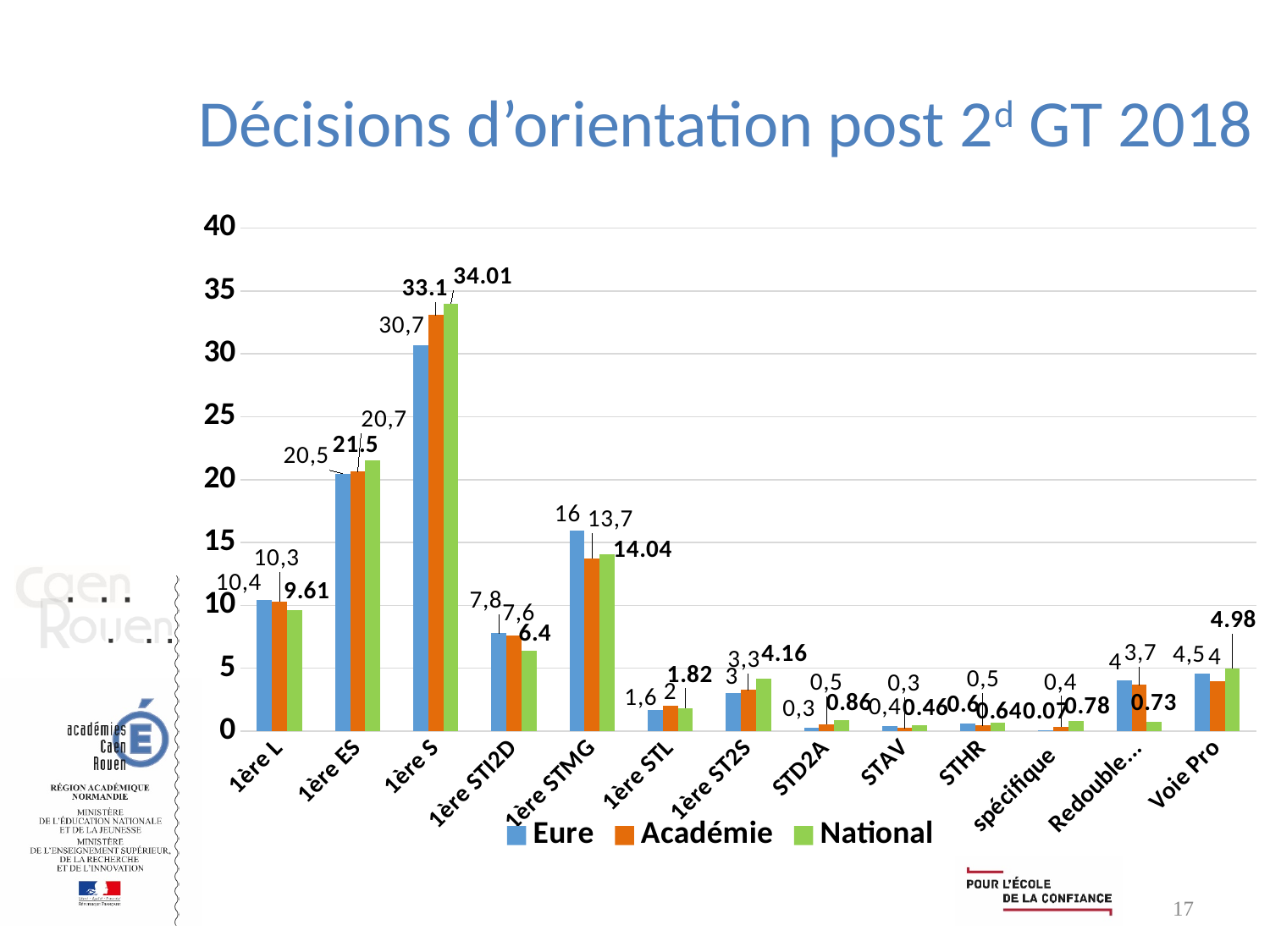
What is the National value for Voie Pro? 4.98 What is the National value for 1ère S? 34.01 What is the difference between the Eure value (16) and the Académie value (13,7) for 1ère STMG? 2,3 Which series does the legend list? Eure, Académie, National How many series does the legend list? 3 For 1ère STMG, which is larger: the Eure value or the Académie value? Eure What kind of chart is shown on the slide? bar chart What is the Eure value for 1ère STMG? 16 Is the Eure value for 1ère ES greater or less than 25? less What is the Eure value for 1ère S? 30,7 How many categories are shown on the x axis? 13 Which category has the highest Eure value? 1ère S